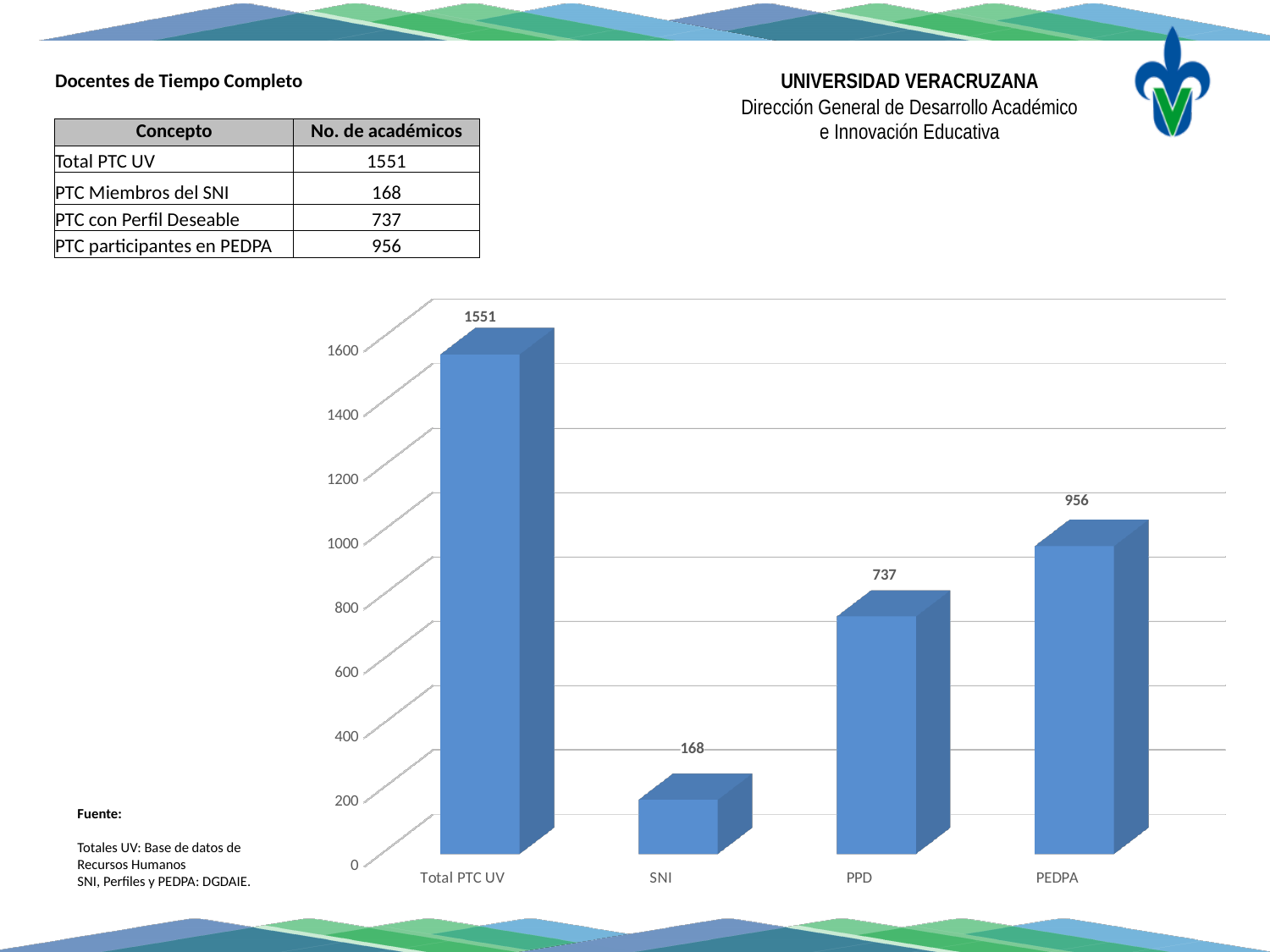
Is the value for PPD greater or less than 800? less Which category has the highest value in the chart? Total PTC UV What is the value for PEDPA in the chart? 956 What is the difference between the values for PEDPA and PPD? 219 Which category has the lowest value in the chart? SNI What is the difference between the values for Total PTC UV and SNI? 1383 What is the value for Total PTC UV in the chart? 1551 What is the value for SNI in the chart? 168 How many categories are shown on the x axis of the chart? 4 What kind of chart is shown on the slide? bar chart Which is larger, the value for PPD or the value for PEDPA? PEDPA What is the value for PPD in the chart? 737